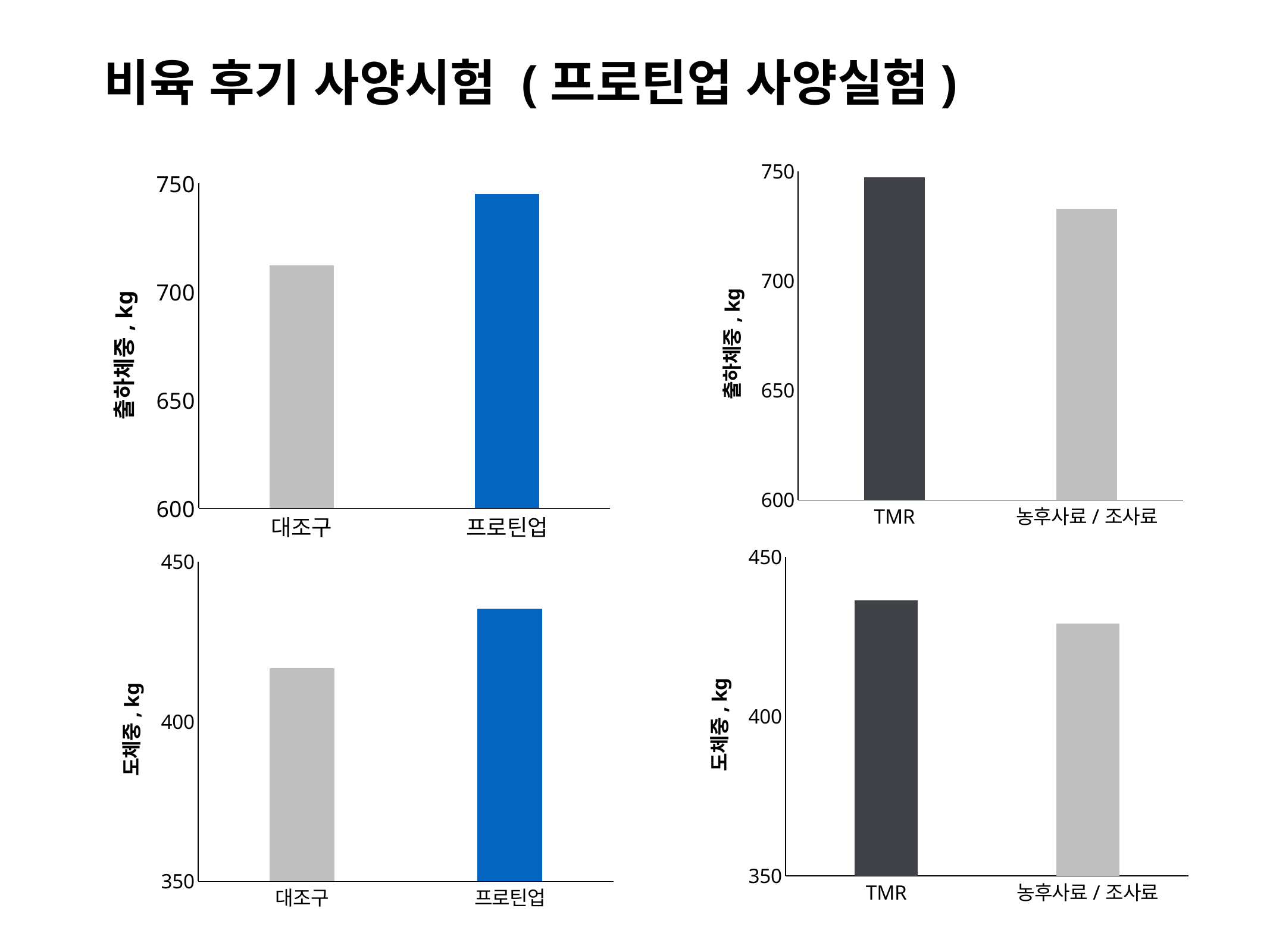
In the bottom-left chart (도체중, kg), is the value for 대조구 greater or less than 400? greater In the bottom-right chart (도체중, kg), is the value for TMR greater or less than 400? greater In the bottom-left chart (도체중, kg), which category has the lowest value? 대조구 In the top-left chart (출하체중, kg), which category has the higher value, 대조구 or 프로틴업? 프로틴업 In the bottom-left chart (도체중, kg), is the value for 프로틴업 greater or less than 450? less In the bottom-right chart (도체중, kg), which category has the larger value, TMR or 농후사료 / 조사료? TMR In the top-left chart (출하체중, kg), how many categories are shown on the x axis? 2 What is the y-axis label of the bottom-right chart? 도체중, kg What kind of chart is the top-left chart on the slide? bar chart In the top-right chart (출하체중, kg), which category has the highest value? TMR